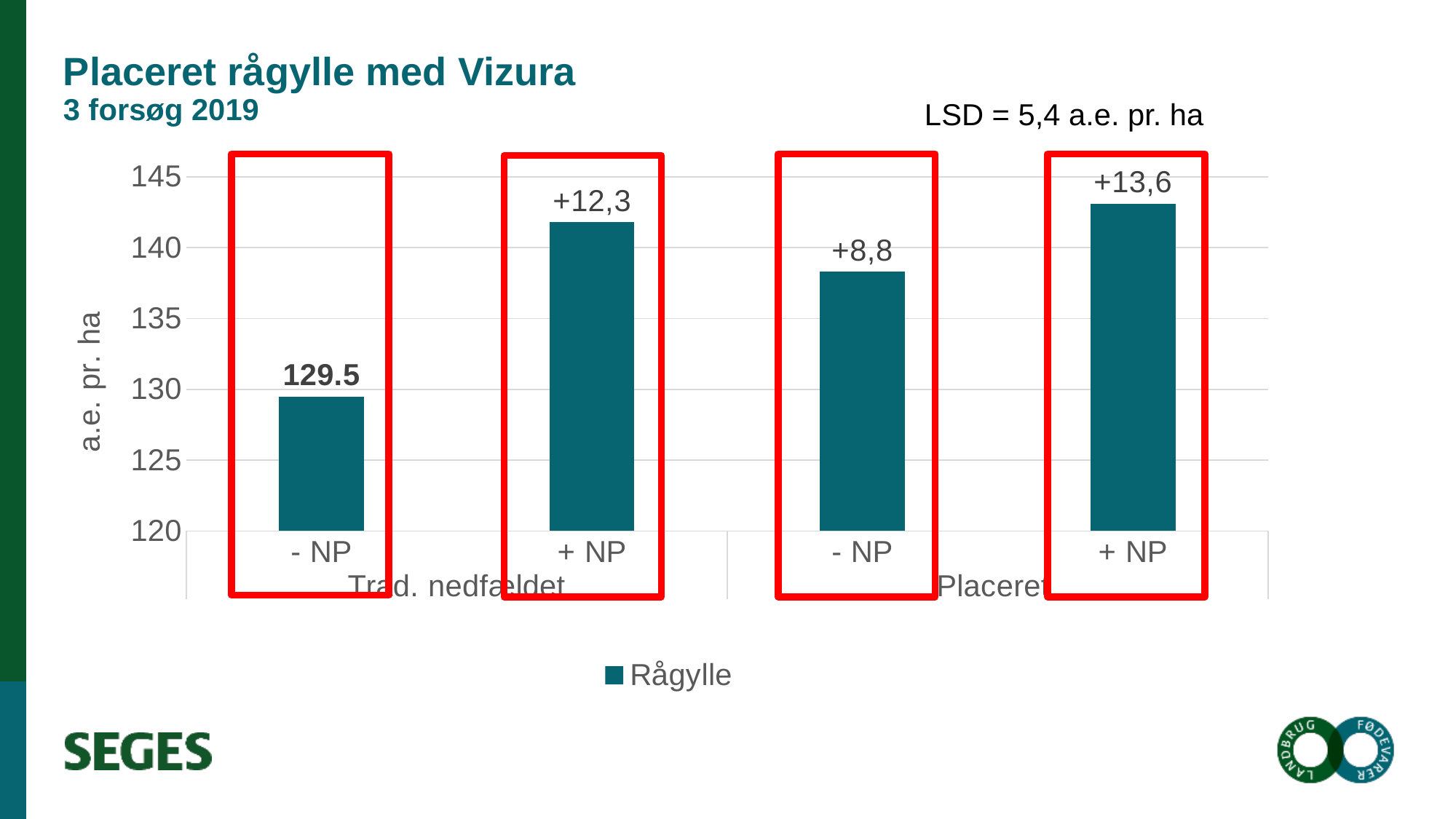
Is the value for + NP under Trad. nedfældet greater or less than 140? greater Is the value for - NP under Placeret greater or less than 140? less What kind of chart is shown on the slide? bar chart What is the data label on the bar for + NP under Trad. nedfældet? +12,3 What is the data label on the bar for + NP under Placeret? +13,6 Which bar is the lowest in the chart? - NP under Trad. nedfældet How many series does the legend list? 1 Which is larger, the bar for + NP under Trad. nedfældet or the bar for - NP under Placeret? + NP under Trad. nedfældet Which bar is the highest in the chart? + NP under Placeret What is the data label on the bar for - NP under Placeret? +8,8 What is the data label on the bar for - NP under Trad. nedfældet? 129.5 How many bars are plotted in the chart? 4